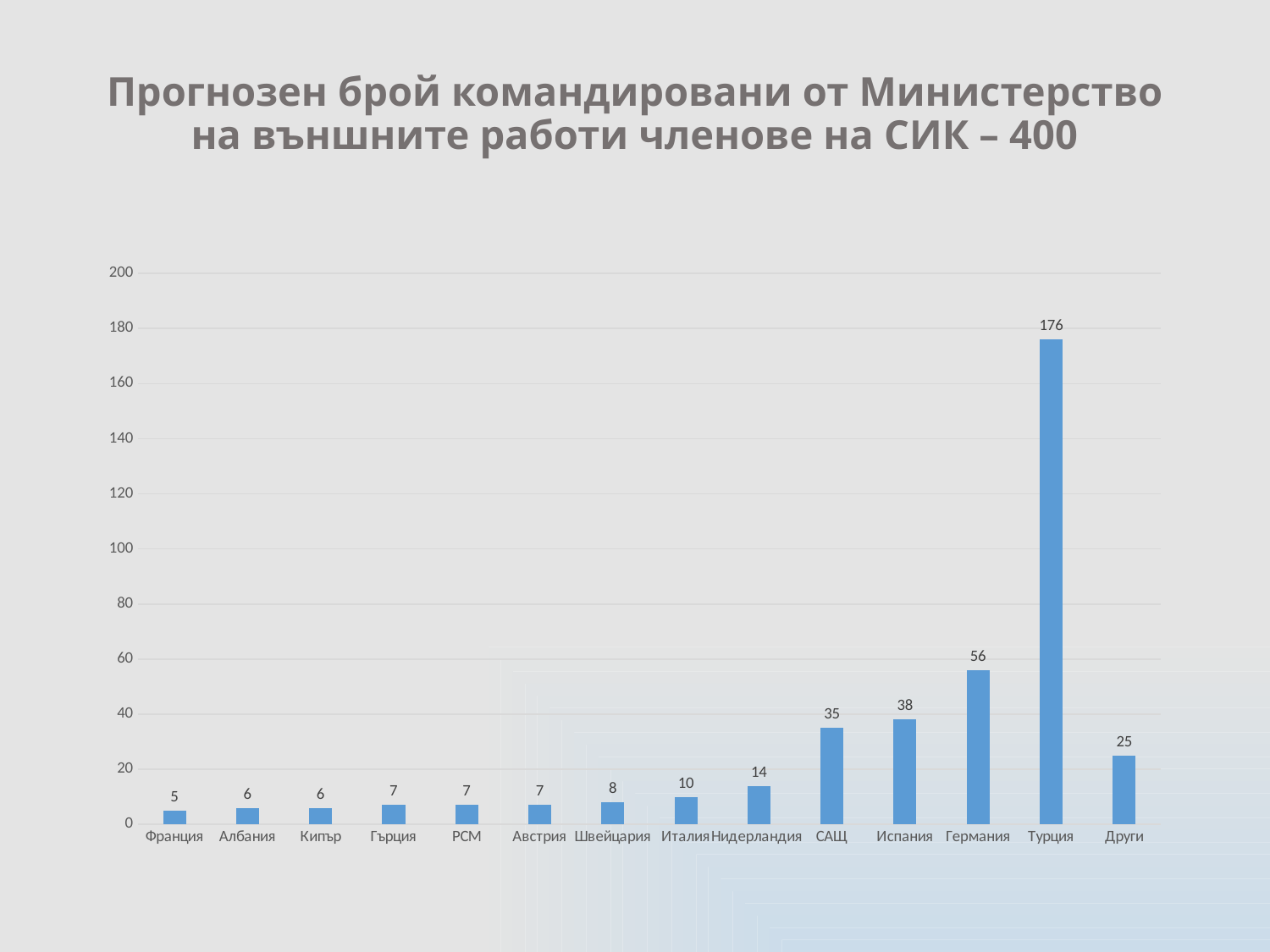
Which is larger, the value for Италия or the value for Швейцария? Италия What is the difference between the values for Турция and Германия? 120 What is the value for Нидерландия? 14 Is the value for Турция greater or less than 160? greater What is the value for Други? 25 How many categories are shown on the x axis? 14 What is the difference between the values for Испания and САЩ? 3 What is the value for Германия? 56 Which category has the highest value? Турция Which category has the lowest value? Франция What kind of chart is shown on the slide? bar chart What is the value for Турция? 176